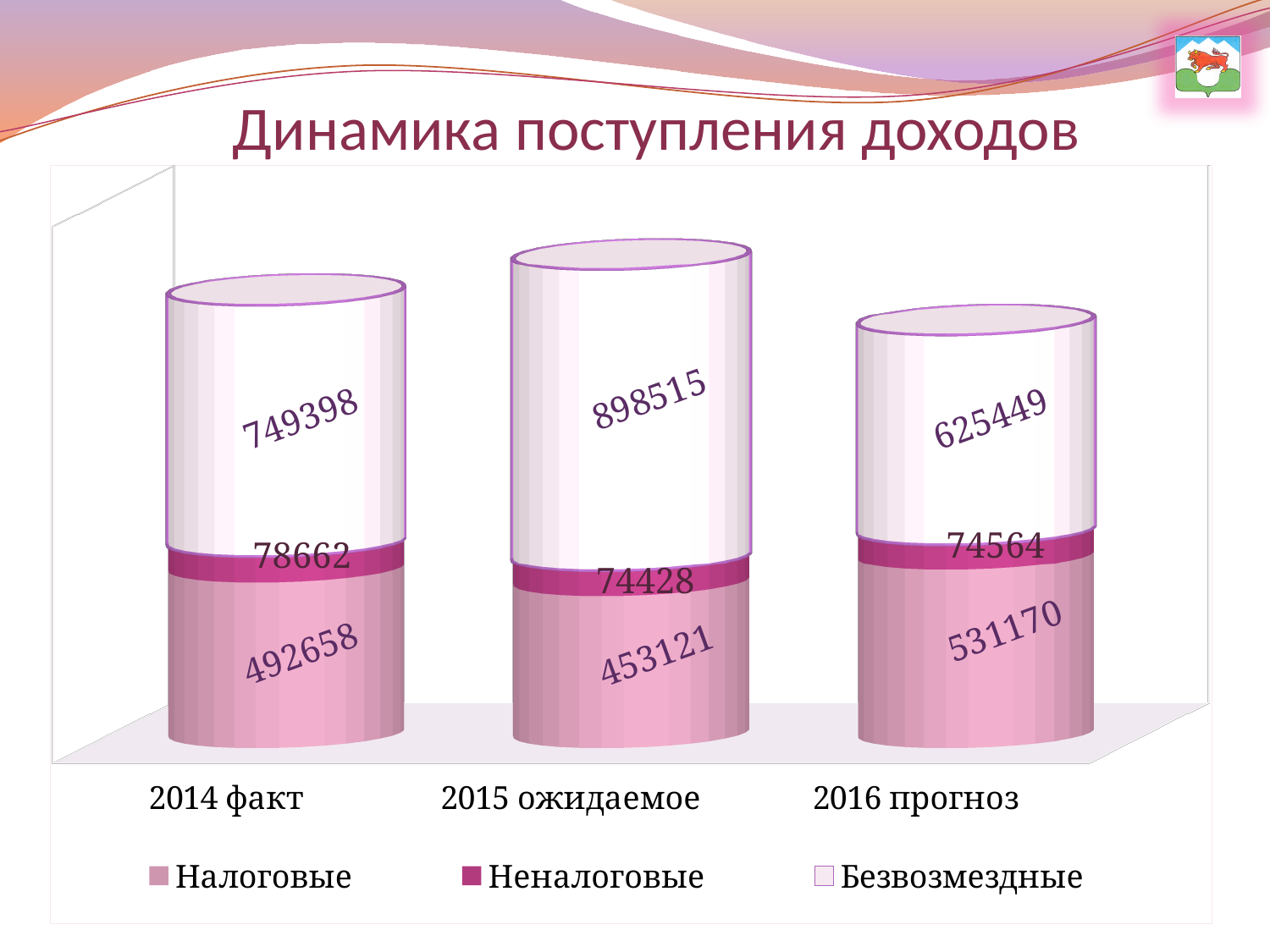
What is the difference between the Безвозмездные values for 2015 ожидаемое and 2014 факт? 149117 What is the value of Налоговые for 2016 прогноз? 531170 Which category has the lowest value for Налоговые? 2015 ожидаемое How many categories are shown on the x axis? 3 What is the value of Неналоговые for 2014 факт? 78662 How many series does the legend list? 3 What is the title of the chart? Динамика поступления доходов What is the total of the stacked bar for 2014 факт? 1320718 Which is larger: Налоговые for 2016 прогноз or Налоговые for 2014 факт? 2016 прогноз Which category has the highest value for Безвозмездные? 2015 ожидаемое What is the value of Безвозмездные for 2015 ожидаемое? 898515 What kind of chart is shown on the slide? stacked bar chart